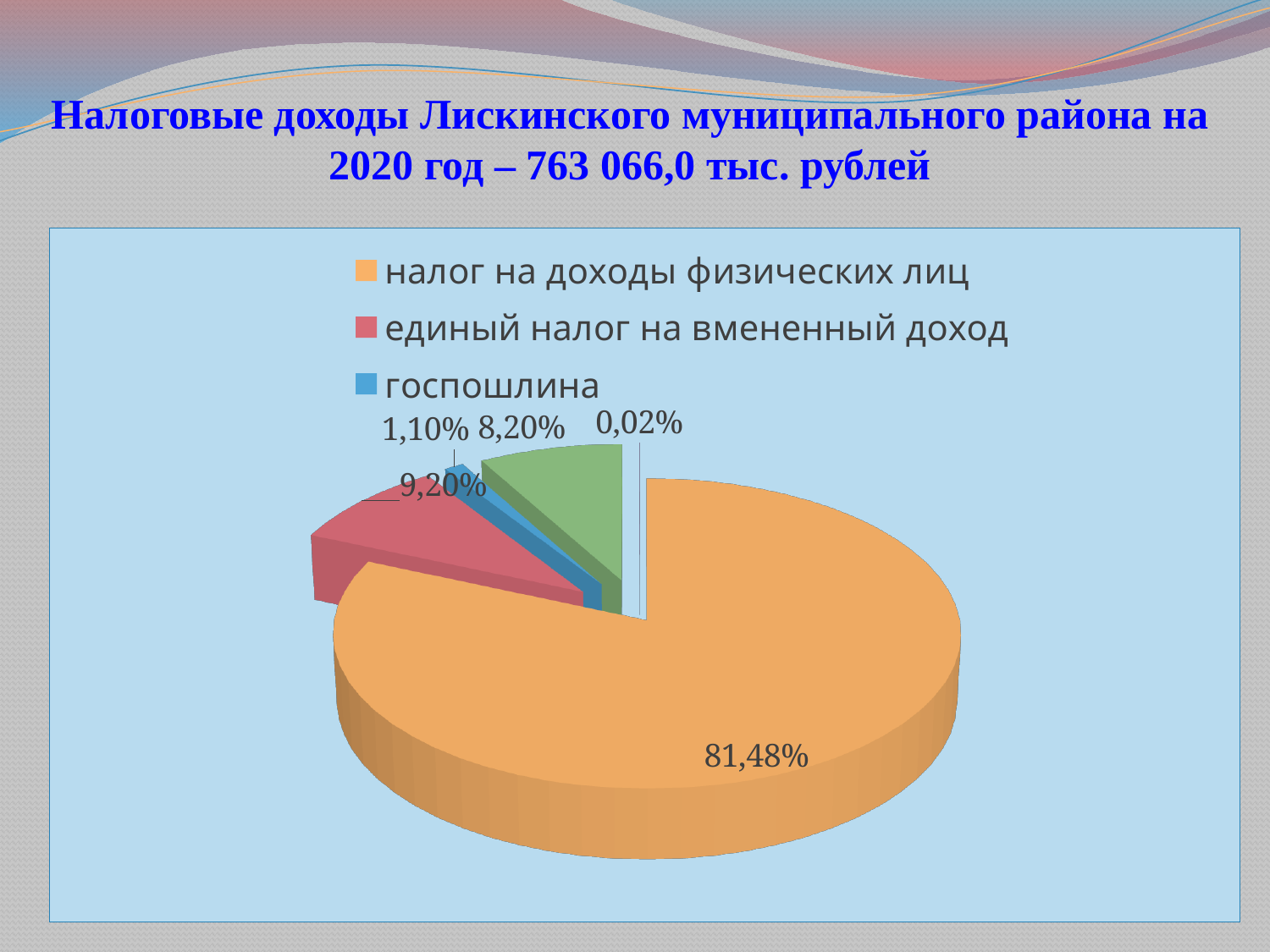
What kind of chart is shown on the slide? pie chart What is the difference in percentage points between the slice for налог на доходы физических лиц and the slice for единый налог на вмененный доход? 72,28% What is the difference in percentage points between the slice for единый налог на вмененный доход and the slice for госпошлина? 8,10% What share of the pie does госпошлина have? 1,10% Which legend category has the largest slice of the pie? налог на доходы физических лиц What colour is the slice for госпошлина? blue What share of the pie does единый налог на вмененный доход have? 9,20% Which is larger: the slice for единый налог на вмененный доход or the slice for госпошлина? единый налог на вмененный доход What is the smallest percentage value labelled on the pie? 0,02% How many slices of the pie have a percentage label? 5 What share of the pie does налог на доходы физических лиц have? 81,48% How many entries are listed in the chart legend? 3